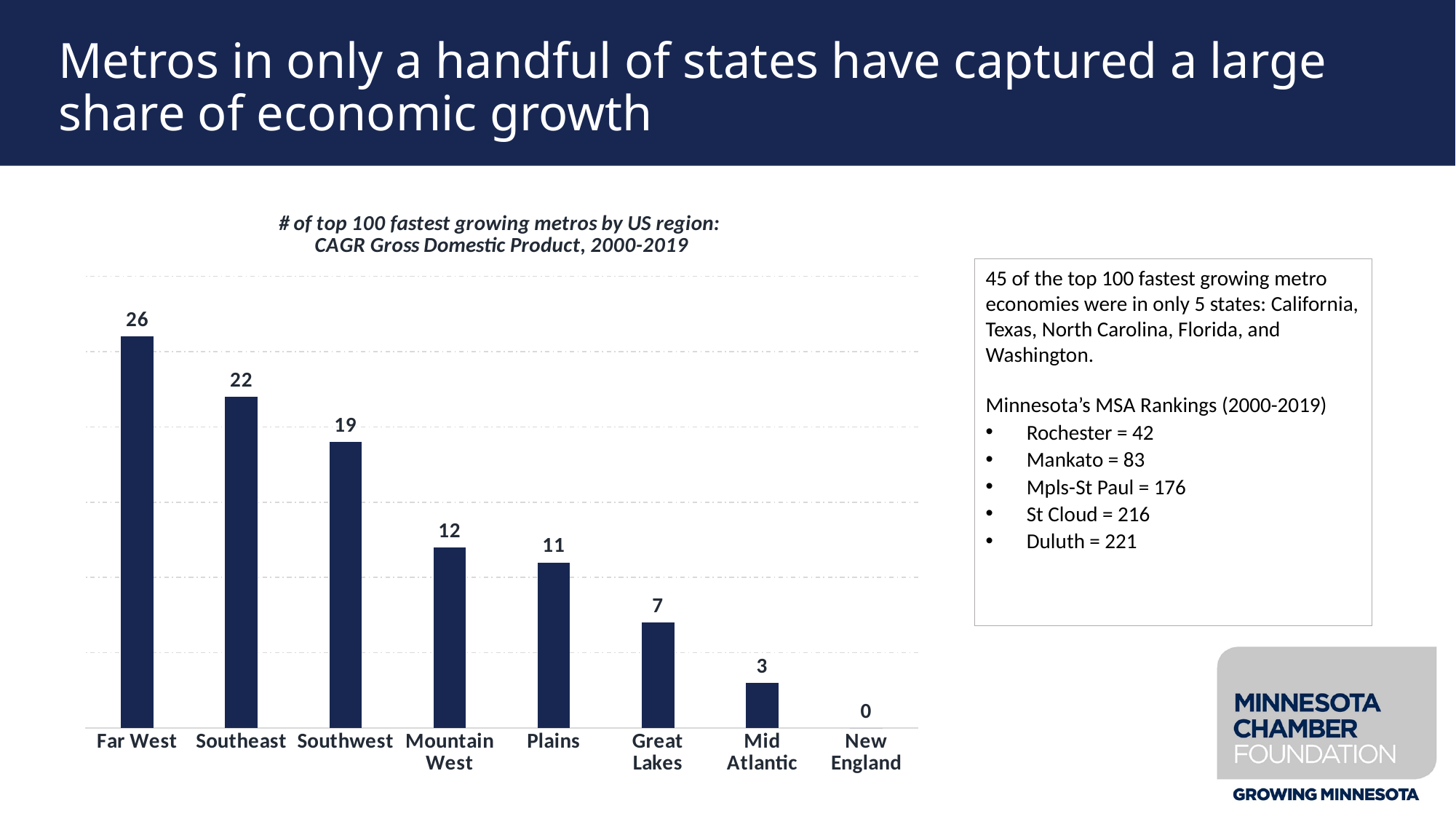
Do the values rise or fall moving from left to right across the regions? Fall What time period does the chart title say the CAGR of Gross Domestic Product covers? 2000-2019 What is the difference between the Mountain West and Mid Atlantic values? 9 Which region has more top 100 fastest growing metros, Plains or Great Lakes? Plains Which region has the highest number of top 100 fastest growing metros? Far West Which region has the lowest number of top 100 fastest growing metros? New England How many top 100 fastest growing metros does the Great Lakes region have? 7 How many regions are shown on the chart? 8 How many of the top 100 fastest growing metros are in the Far West region? 26 What is the difference between the Far West and Southeast values? 4 What kind of chart is shown on the slide? Bar chart What is the value shown for the Southwest region? 19